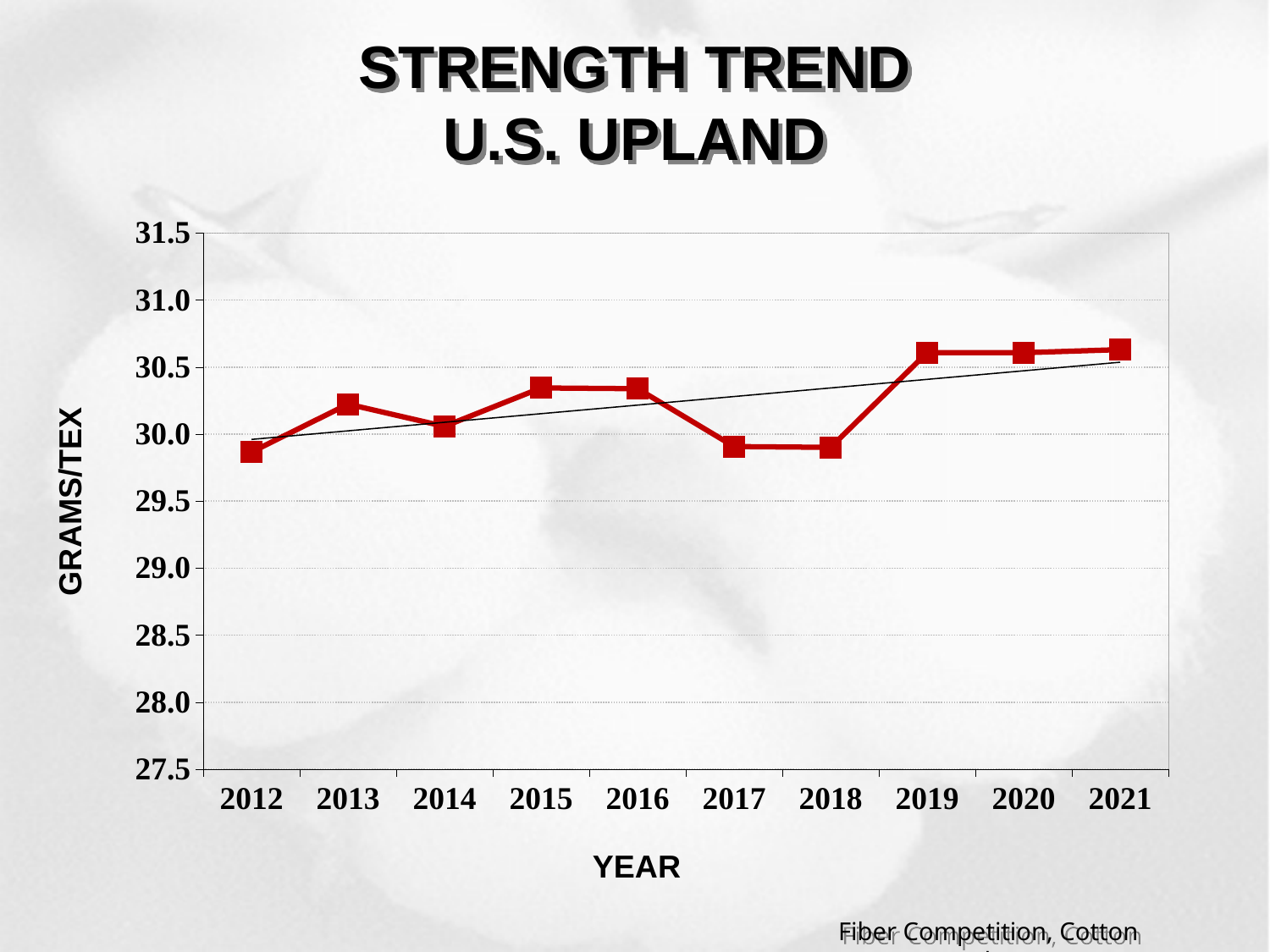
Do the values generally rise or fall from 2012 to 2021? rise Which year has the higher value, 2012 or 2013? 2013 Is the value for 2019 greater or less than 30.5? greater Is the value for 2021 greater or less than 30.5? greater Is the value for 2012 greater or less than 30.0? less Which year has the higher value, 2018 or 2019? 2019 What kind of chart is shown on the slide? line chart How many years are plotted on the chart? 10 What is the label on the vertical axis? GRAMS/TEX Which year has the higher value, 2016 or 2017? 2016